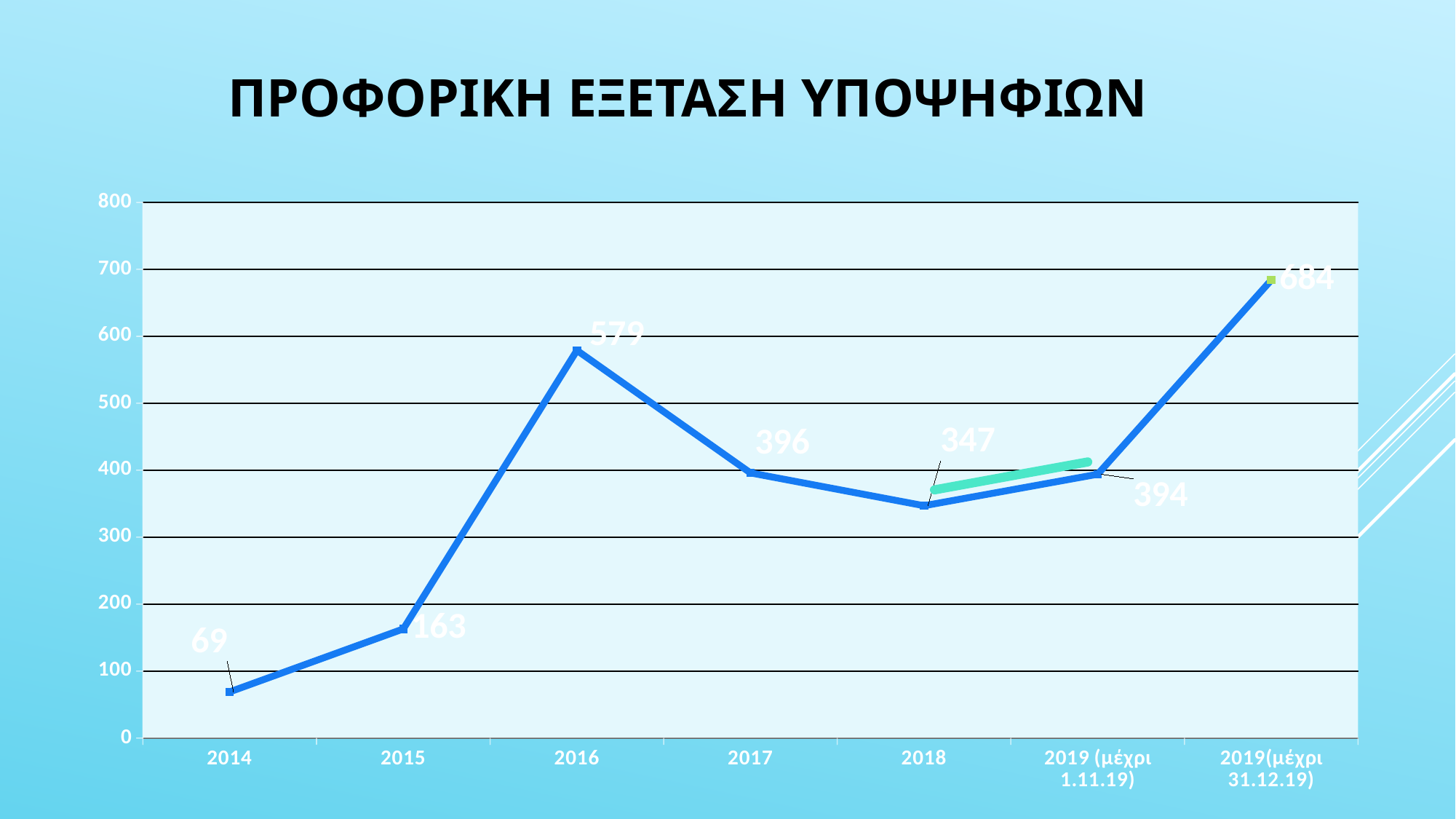
Which category has the lowest value? 2014 What is the value for 2016? 579 What is the title of the chart? ΠΡΟΦΟΡΙΚΗ ΕΞΕΤΑΣΗ ΥΠΟΨΗΦΙΩΝ Which category has the highest value? 2019(μέχρι 31.12.19) What is the value for 2018? 347 How many data points are plotted on the chart? 7 What is the value for 2019 (μέχρι 31.12.19)? 684 What is the value for 2014? 69 What is the difference between the values for 2015 and 2014? 94 What kind of chart is shown on the slide? Line chart What is the difference between the values for 2016 and 2017? 183 Which is larger, the value for 2017 or the value for 2018? 2017